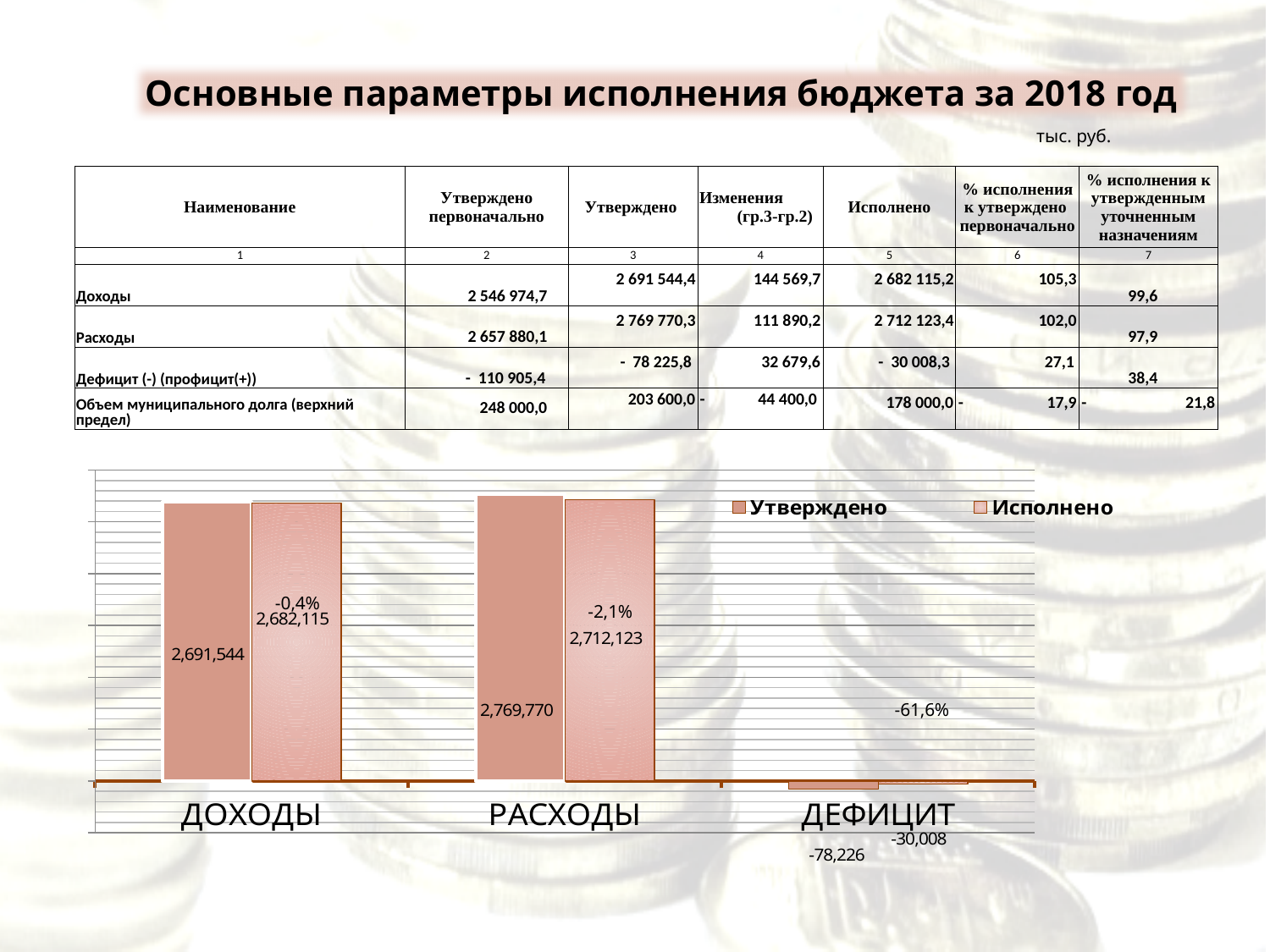
What is the Исполнено value for ДЕФИЦИТ in the chart? -30,008 What kind of chart is shown on the slide? bar chart What is the Исполнено value for ДОХОДЫ in the chart? 2,682,115 What is the Утверждено value for ДОХОДЫ in the chart? 2,691,544 What is the Утверждено value for ДЕФИЦИТ in the chart? -78,226 Which category has the highest Утверждено value in the chart? РАСХОДЫ How many series does the chart legend list? 2 What percentage change is labelled for РАСХОДЫ in the chart? -2,1% How many categories are shown on the chart's x axis? 3 Which is larger in the chart: the Утверждено value for РАСХОДЫ or the Исполнено value for РАСХОДЫ? Утверждено What is the Исполнено value for РАСХОДЫ in the chart? 2,712,123 What is the Утверждено value for РАСХОДЫ in the chart? 2,769,770